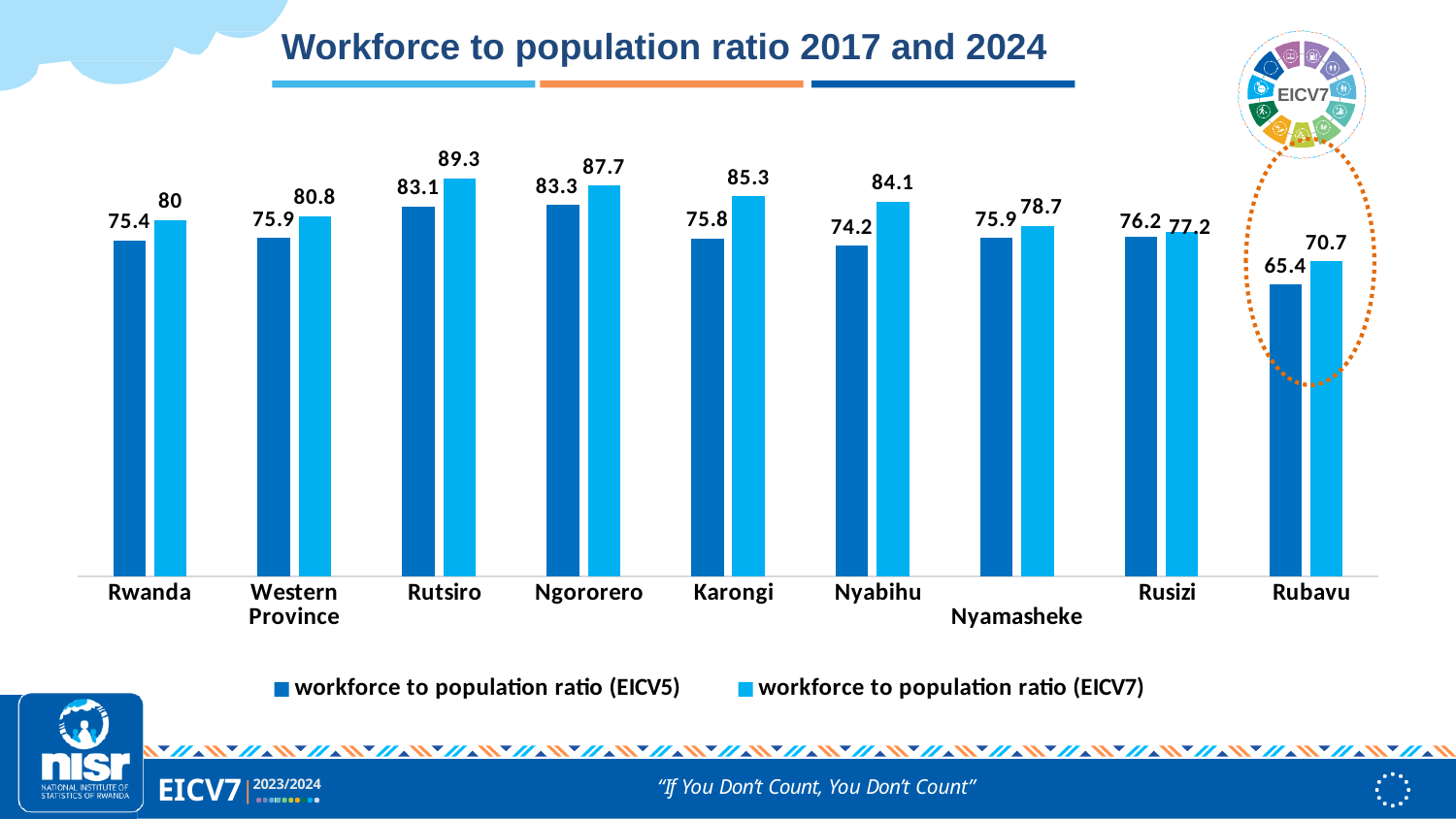
What is the title of the chart? Workforce to population ratio 2017 and 2024 Which category has the highest workforce to population ratio (EICV7)? Rutsiro What is the difference between the EICV7 and EICV5 workforce to population ratio for Nyabihu? 9.9 What is the workforce to population ratio (EICV7) for Rutsiro? 89.3 Which category has the lowest workforce to population ratio (EICV5)? Rubavu How many categories are shown on the x axis of the chart? 9 Which is larger, the EICV5 workforce to population ratio for Ngororero or for Karongi? Ngororero What is the workforce to population ratio (EICV5) for Rubavu? 65.4 What kind of chart is shown on the slide? Bar chart What is the difference between the EICV7 and EICV5 workforce to population ratio for Rusizi? 1 What is the workforce to population ratio (EICV7) for Rwanda? 80 How many series does the legend list? 2